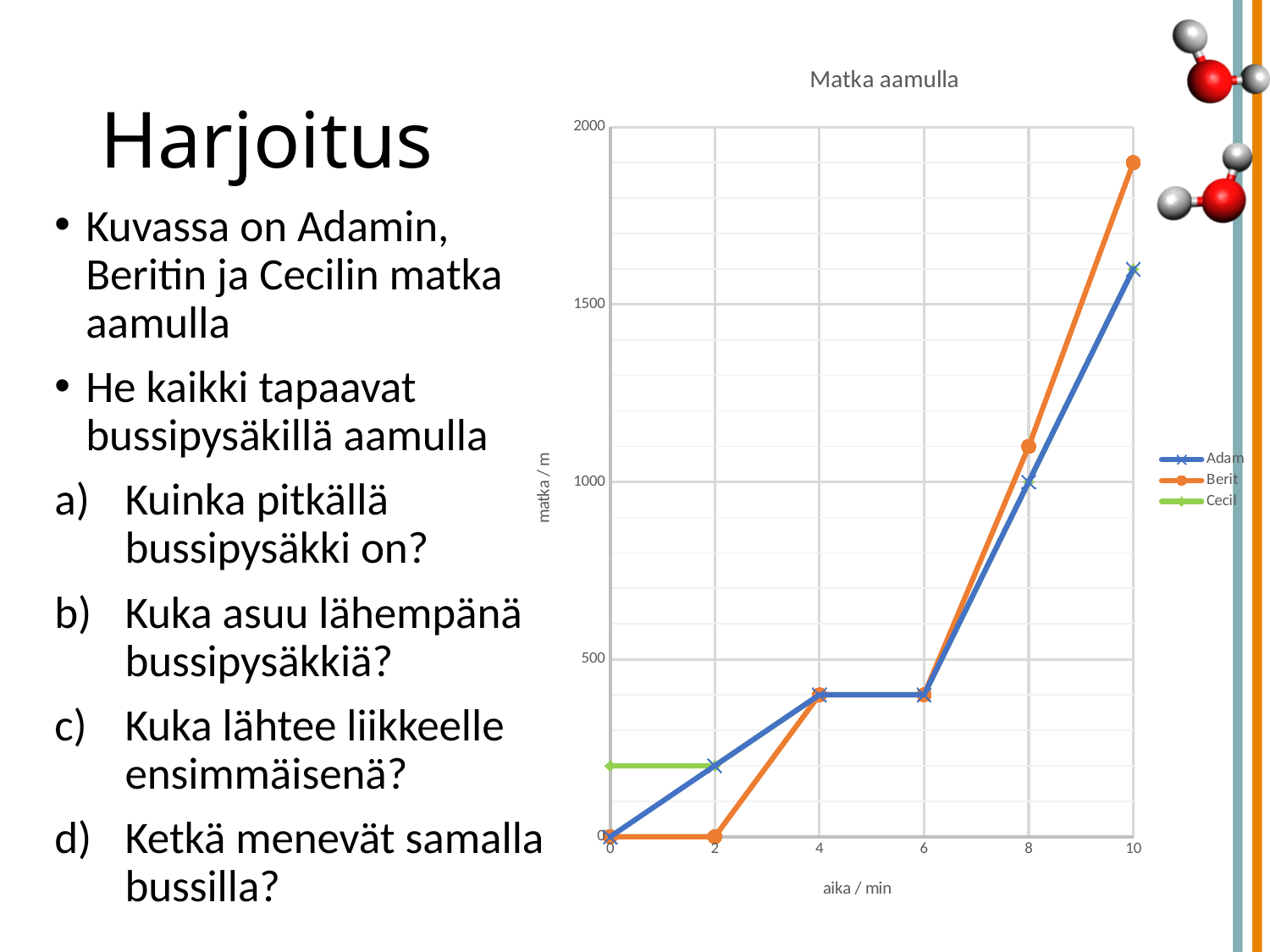
How many series does the legend of the chart list? 3 What is the title of the chart? Matka aamulla Is the value for Cecil at 0 min greater or less than 500? less What is the value for Berit at 2 min? 0 What kind of chart is shown on the slide? line chart Is the value for Adam at 10 min greater or less than 1500? greater Is the value for Adam at 4 min greater or less than 500? less Does the line for Berit rise or fall from 6 min to 10 min? rise What is the value for Adam at 8 min? 1000 What is the label of the x axis of the chart? aika / min At 10 min, which is larger: the value for Adam or the value for Berit? Berit